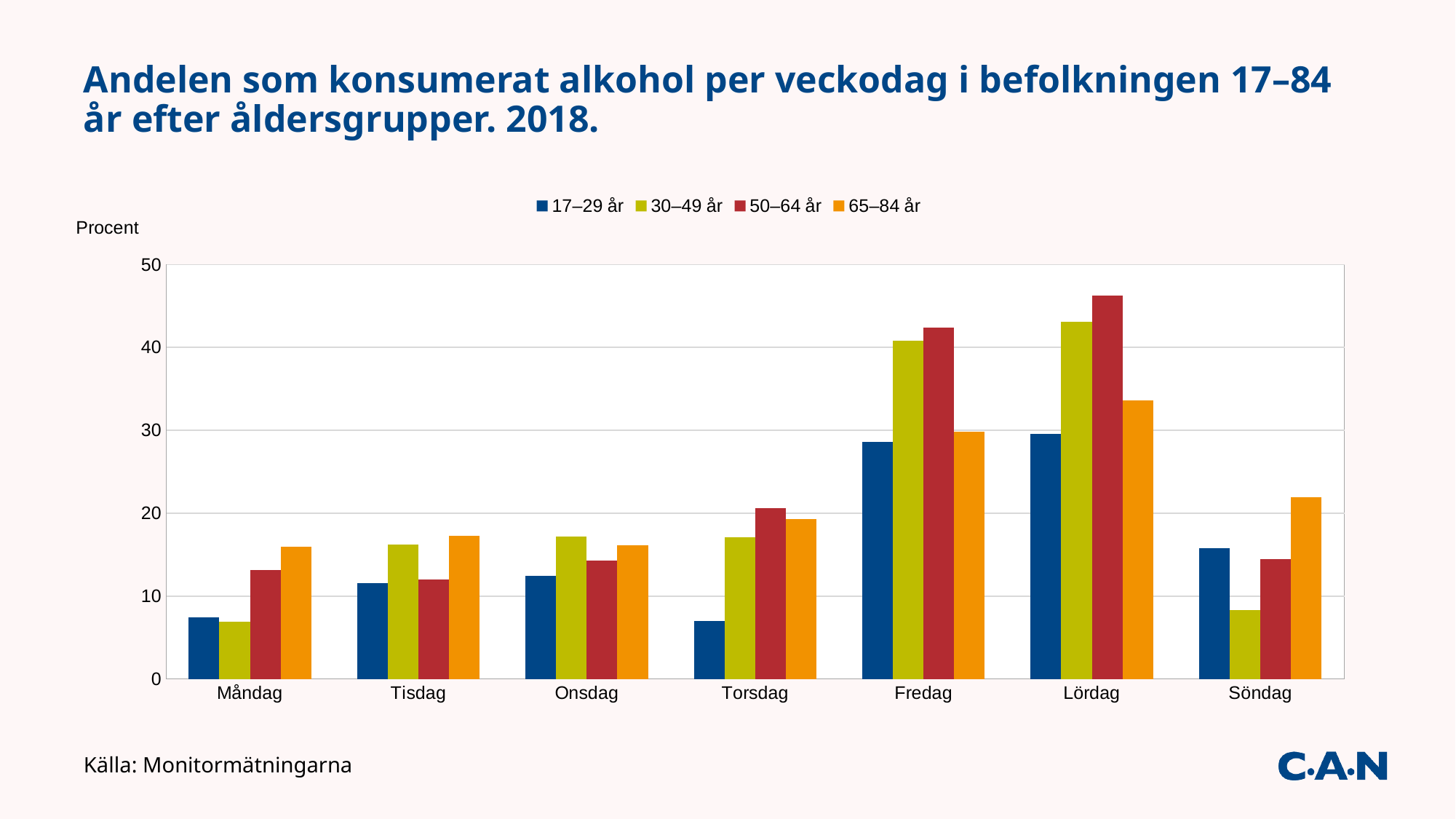
On which weekday is the value for 30–49 år lowest? Måndag Is the value for 65–84 år on Söndag greater or less than 20? greater On which weekday is the value for 50–64 år highest? Lördag Is the value for 50–64 år on Fredag greater or less than 40? greater What kind of chart is shown on the slide? bar chart On which weekday is the value for 65–84 år highest? Lördag Is the value for 17–29 år on Torsdag greater or less than 10? less How many weekdays are shown on the x axis? 7 On Söndag, which age group has the larger value: 17–29 år or 65–84 år? 65–84 år Do the values for 50–64 år rise or fall from Torsdag to Lördag? rise How many age groups does the legend list? 4 What is the label on the vertical axis? Procent